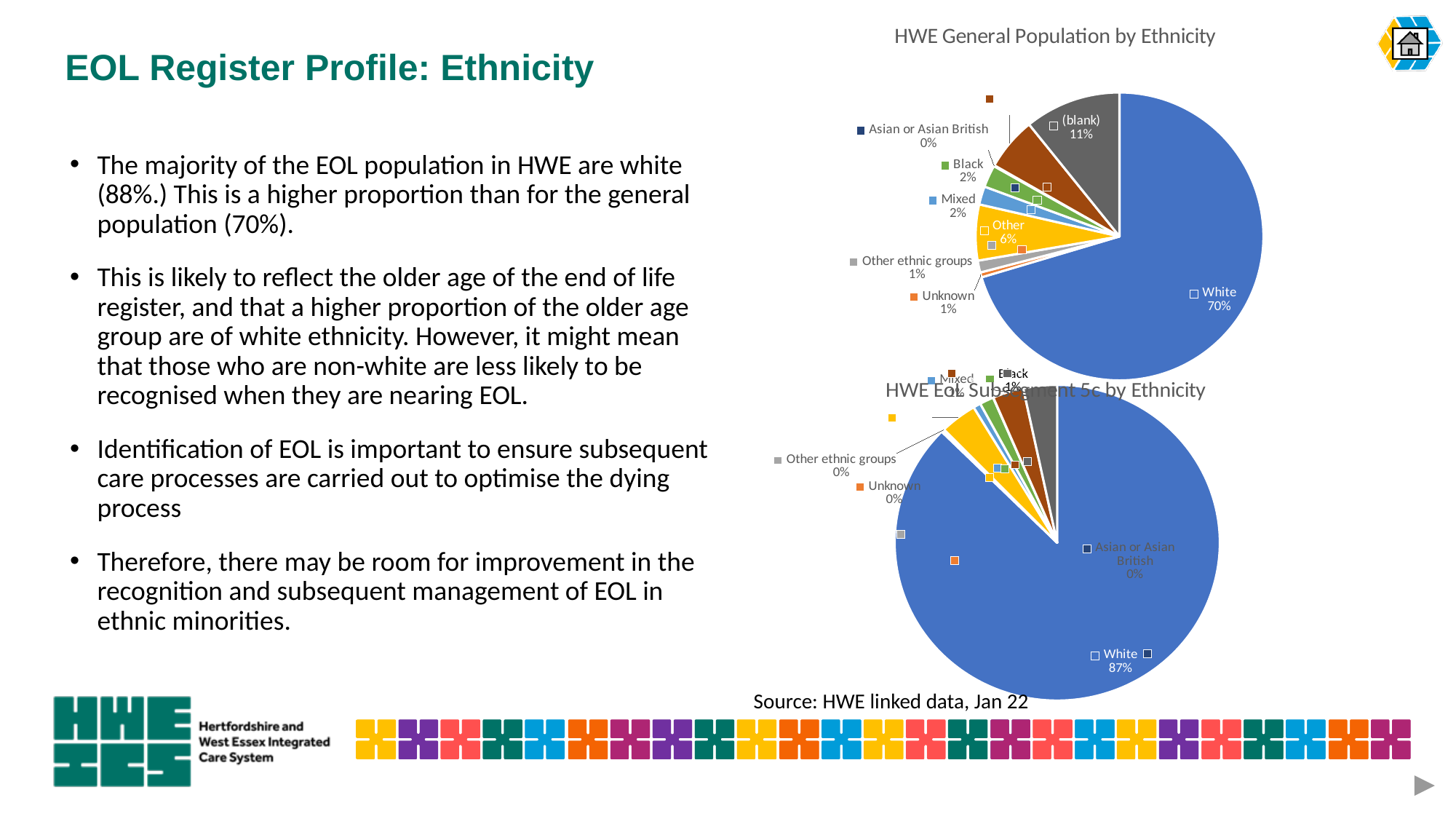
In the HWE General Population by Ethnicity chart, what share of the pie is White? 70% In the HWE General Population by Ethnicity chart, what is the share for Unknown? 1% In the HWE General Population by Ethnicity chart, what is the share for Black? 2% What is the title of the upper chart on the slide? HWE General Population by Ethnicity In the HWE General Population by Ethnicity chart, what is the share for Other? 6% In the HWE General Population by Ethnicity chart, which is larger, the Other slice or the Black slice? Other In the HWE General Population by Ethnicity chart, what is the difference in percentage points between the White slice and the (blank) slice? 59 In the HWE EoL Subsegment 5c by Ethnicity chart, what percentage is shown for Asian or Asian British? 0% In the HWE EoL Subsegment 5c by Ethnicity chart, what share of the pie is White? 87% In the HWE General Population by Ethnicity chart, what percentage is labelled (blank)? 11% In the HWE General Population by Ethnicity chart, which category has the largest slice? White What type of chart is used for HWE General Population by Ethnicity? Pie chart